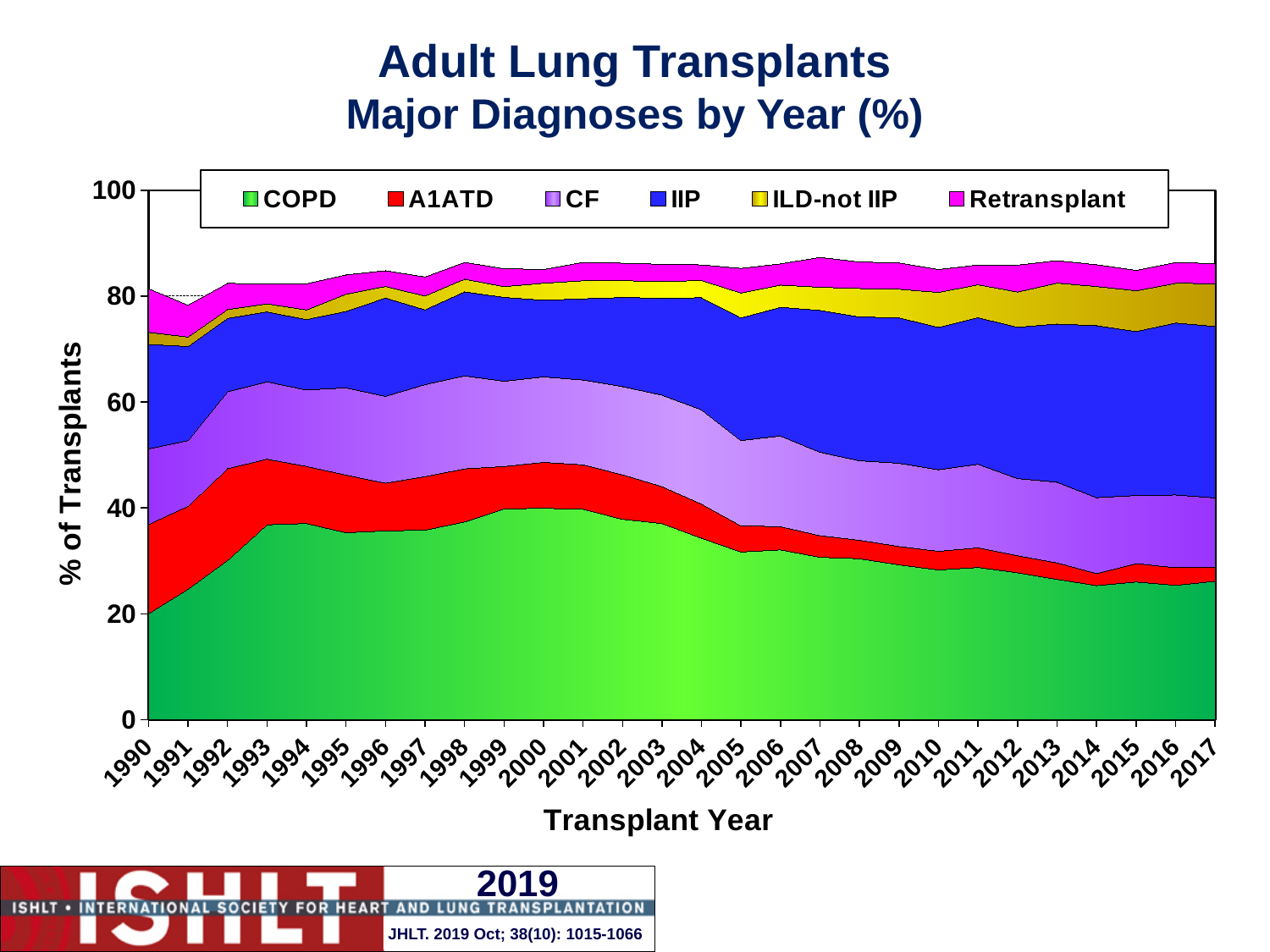
Is the COPD share larger in 1993 or in 2017? 1993 How many series does the legend list? 6 Is the COPD share in 2017 greater or less than 40? less What is the label of the y axis? % of Transplants What kind of chart is shown on the slide? Stacked area chart Does the COPD share rise or fall from 2000 to 2017? fall Which series is listed first in the legend? COPD Is the COPD share in 1993 greater or less than 20? greater Is the COPD share in 2014 greater or less than 20? greater Does the COPD share rise or fall from 1990 to 1993? rise How many transplant years are plotted along the x axis? 28